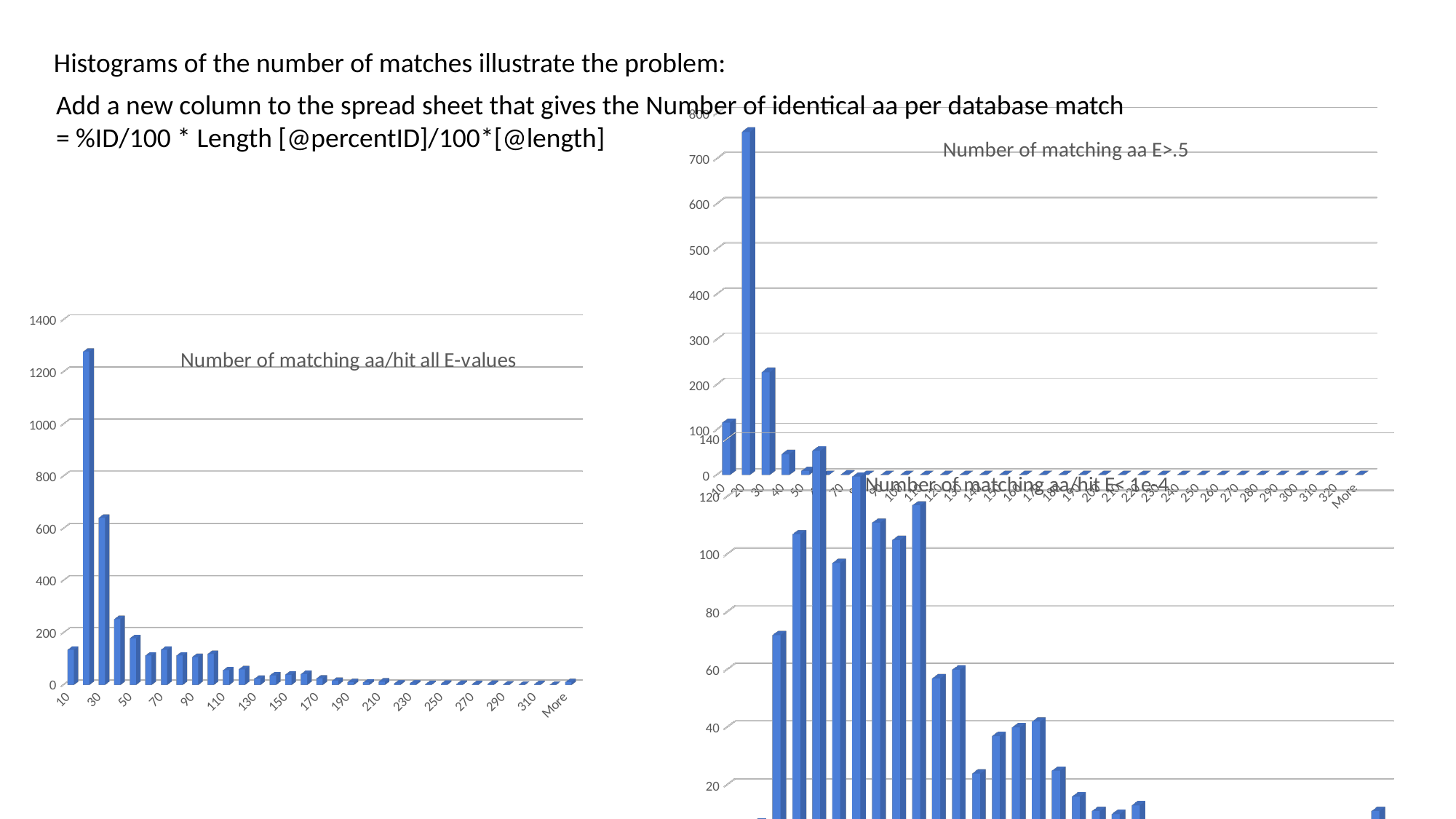
In the "Number of matching aa/hit all E-values" chart, which is larger, the value for 30 or the value for 50? 30 In the "Number of matching aa E>.5" chart, which category has the highest value? 20 What kind of chart is "Number of matching aa/hit all E-values"? bar chart What is the title of the chart in the top right of the slide? Number of matching aa E>.5 In the "Number of matching aa/hit all E-values" chart, is the tallest bar greater or less than 1200? greater In the "Number of matching aa/hit all E-values" chart, do the values generally rise or fall from 30 to 310 along the x axis? fall How many charts are shown on the slide? 3 In the "Number of matching aa E>.5" chart, is the value for 20 greater or less than 700? greater In the "Number of matching aa E>.5" chart, is the value for 40 greater or less than 100? less In the "Number of matching aa E>.5" chart, which is larger, the value for 20 or the value for 30? 20 What is the highest value shown on the y axis of the "Number of matching aa/hit all E-values" chart? 1400